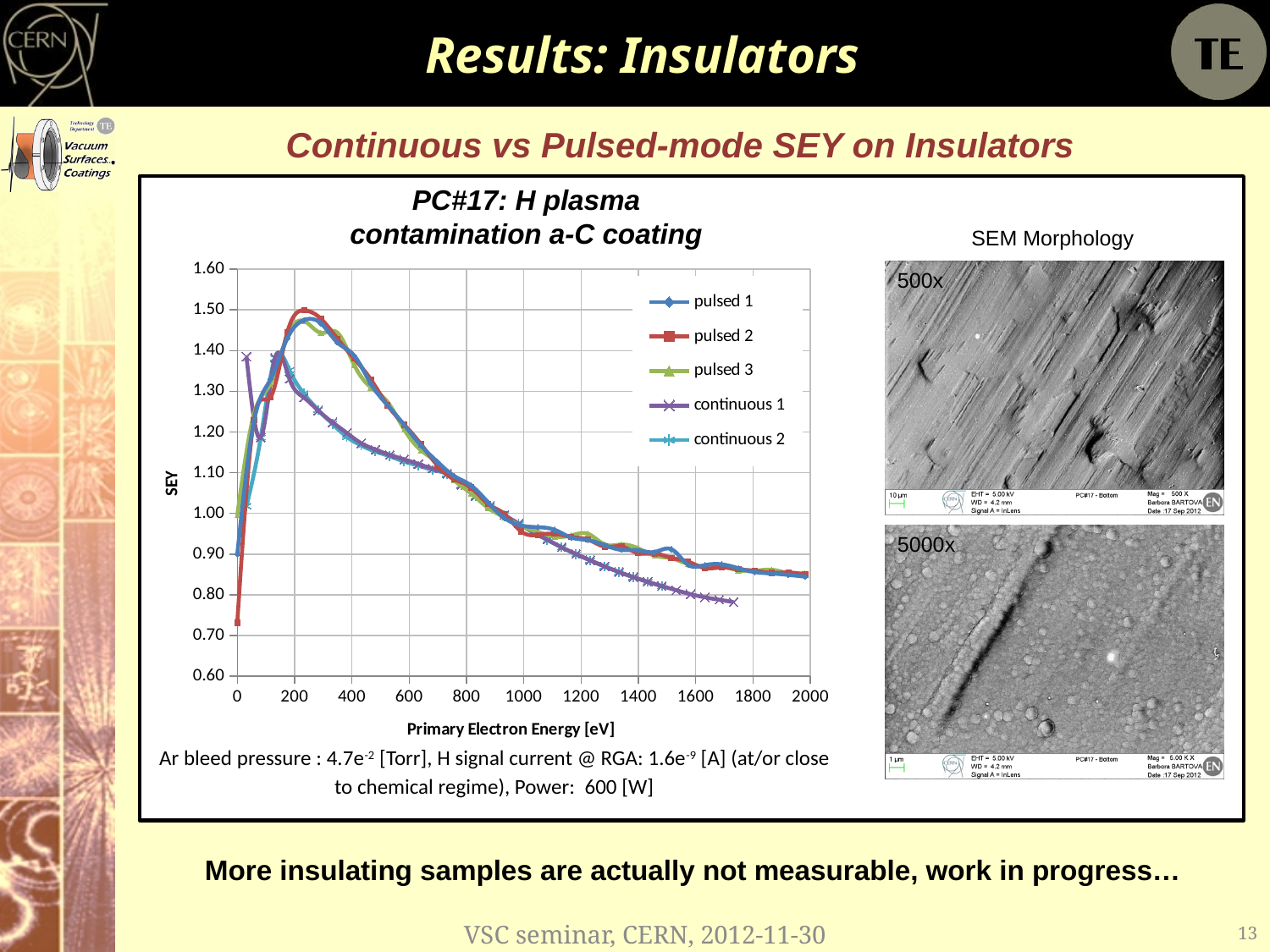
What kind of chart is shown on the slide? line chart What is the label of the x axis of the chart? Primary Electron Energy [eV] Is the SEY value of pulsed 2 at 1000 eV greater or less than 1.00? less Is the peak SEY value of the pulsed 2 series greater or less than 1.40? greater Is the SEY value of continuous 1 at 1600 eV greater or less than 0.90? less How many series does the chart legend list? 5 What is the title of the chart? PC#17: H plasma contamination a-C coating At 1600 eV, which series has the higher SEY: pulsed 3 or continuous 1? pulsed 3 At 400 eV, which series has the higher SEY: pulsed 2 or continuous 1? pulsed 2 Between 400 eV and 2000 eV, does the SEY of the pulsed 1 series rise or fall as primary electron energy increases? fall